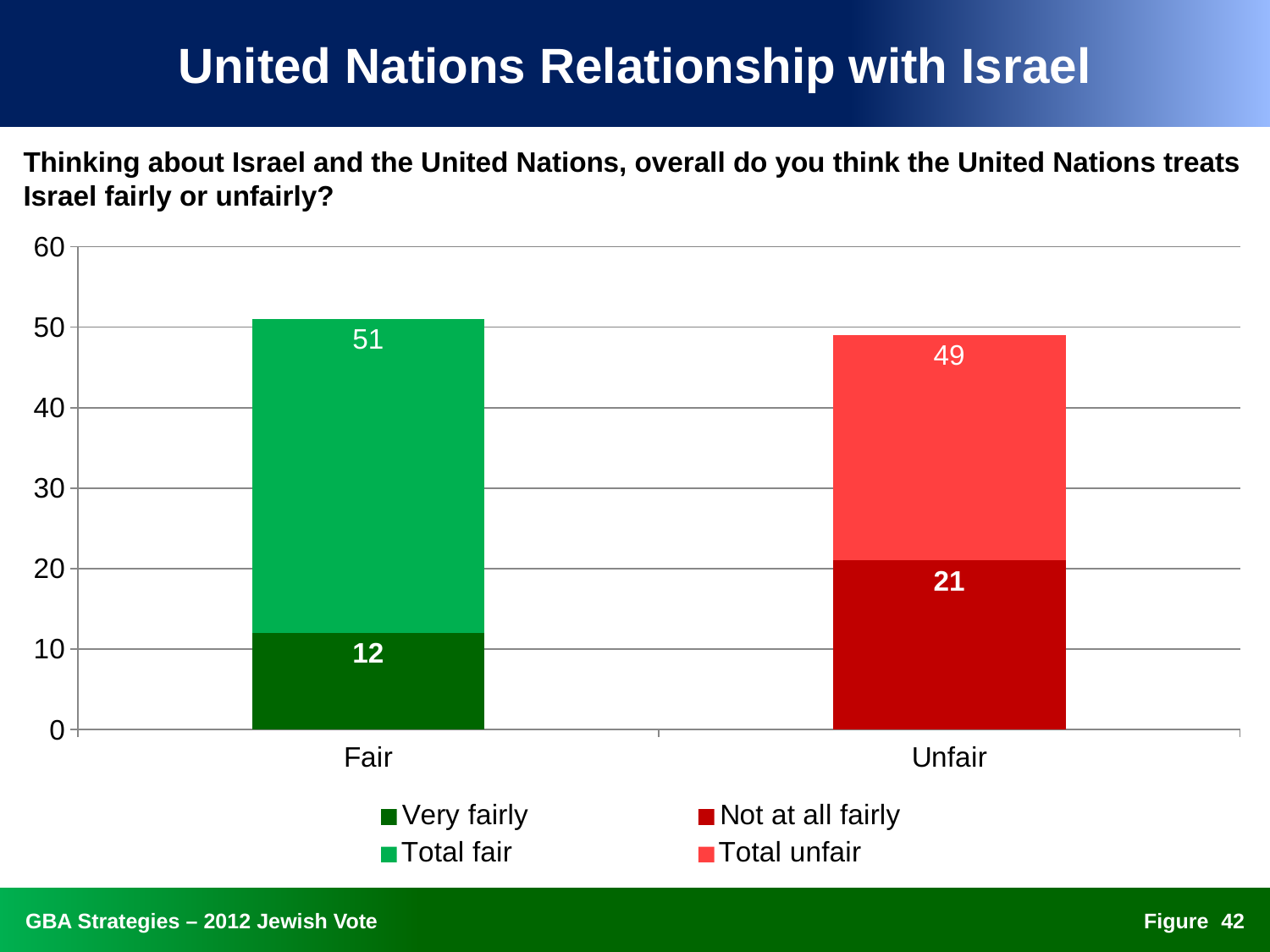
How many series does the legend list? 4 What value is labelled for Total unfair in the Unfair bar? 49 What is the difference between the Not at all fairly value and the Very fairly value? 9 What kind of chart is shown on the slide? Bar chart What is the difference between the Total fair value (51) and the Total unfair value (49)? 2 What value is labelled for Not at all fairly in the Unfair bar? 21 What colour is the Very fairly series in the legend? Dark green Which is larger, the Total fair value or the Total unfair value? Total fair How many categories are shown on the x axis? 2 What value is labelled for Very fairly in the Fair bar? 12 What value is labelled for Total fair in the Fair bar? 51 Which is larger, the Very fairly value or the Not at all fairly value? Not at all fairly